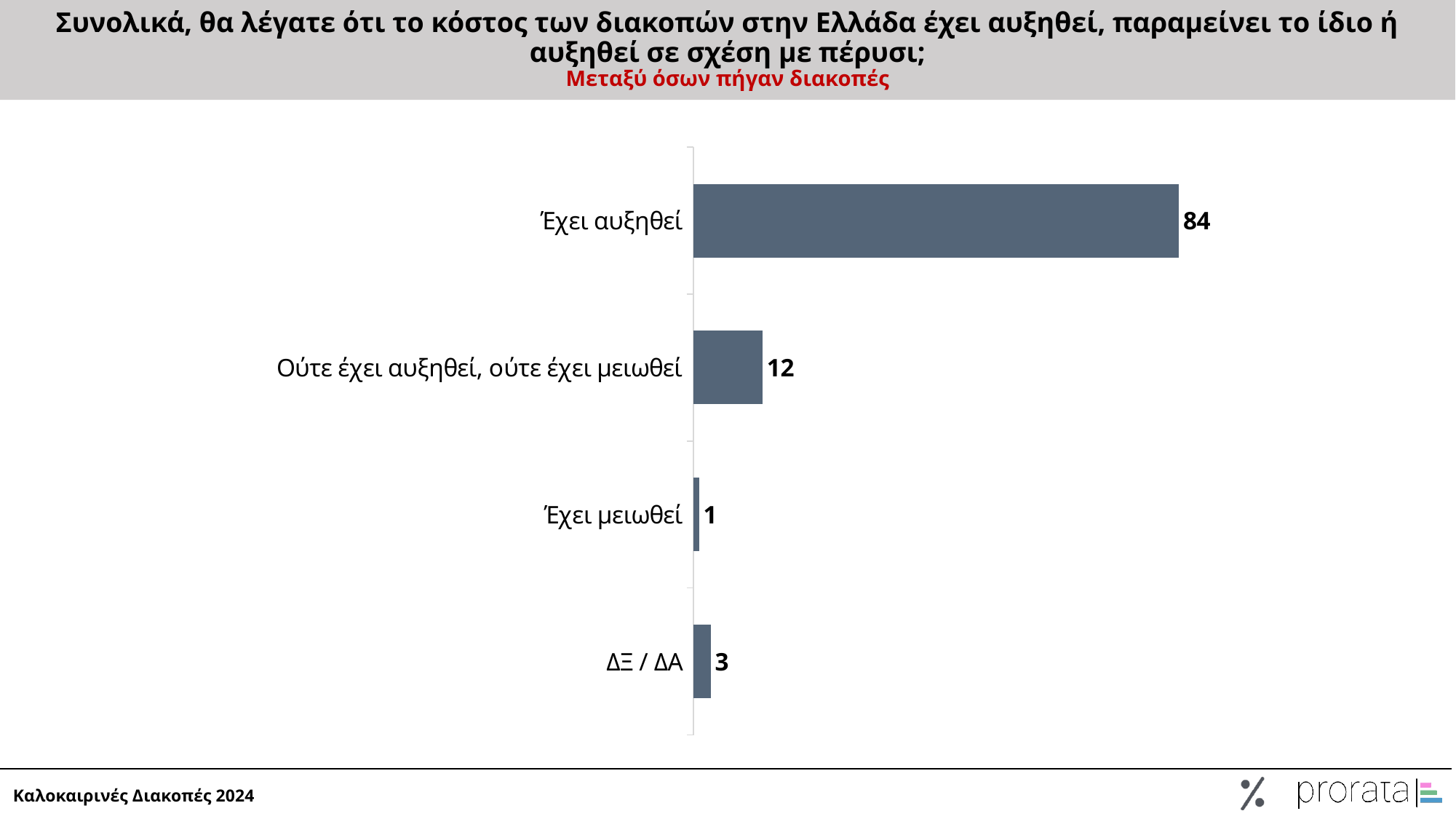
What is the value for 'ΔΞ / ΔΑ'? 3 Which is larger, the value for 'ΔΞ / ΔΑ' or the value for 'Έχει μειωθεί'? ΔΞ / ΔΑ What is the value for 'Έχει μειωθεί'? 1 What is the difference between the values for 'Έχει αυξηθεί' and 'Ούτε έχει αυξηθεί, ούτε έχει μειωθεί'? 72 What is the value for 'Έχει αυξηθεί'? 84 Which category has the highest value? Έχει αυξηθεί What is the difference between the values for 'ΔΞ / ΔΑ' and 'Έχει μειωθεί'? 2 How many categories are shown in the chart? 4 Which category has the lowest value? Έχει μειωθεί What is the value for 'Ούτε έχει αυξηθεί, ούτε έχει μειωθεί'? 12 What is the red subtitle text under the chart title? Μεταξύ όσων πήγαν διακοπές What kind of chart is shown on the slide? Bar chart